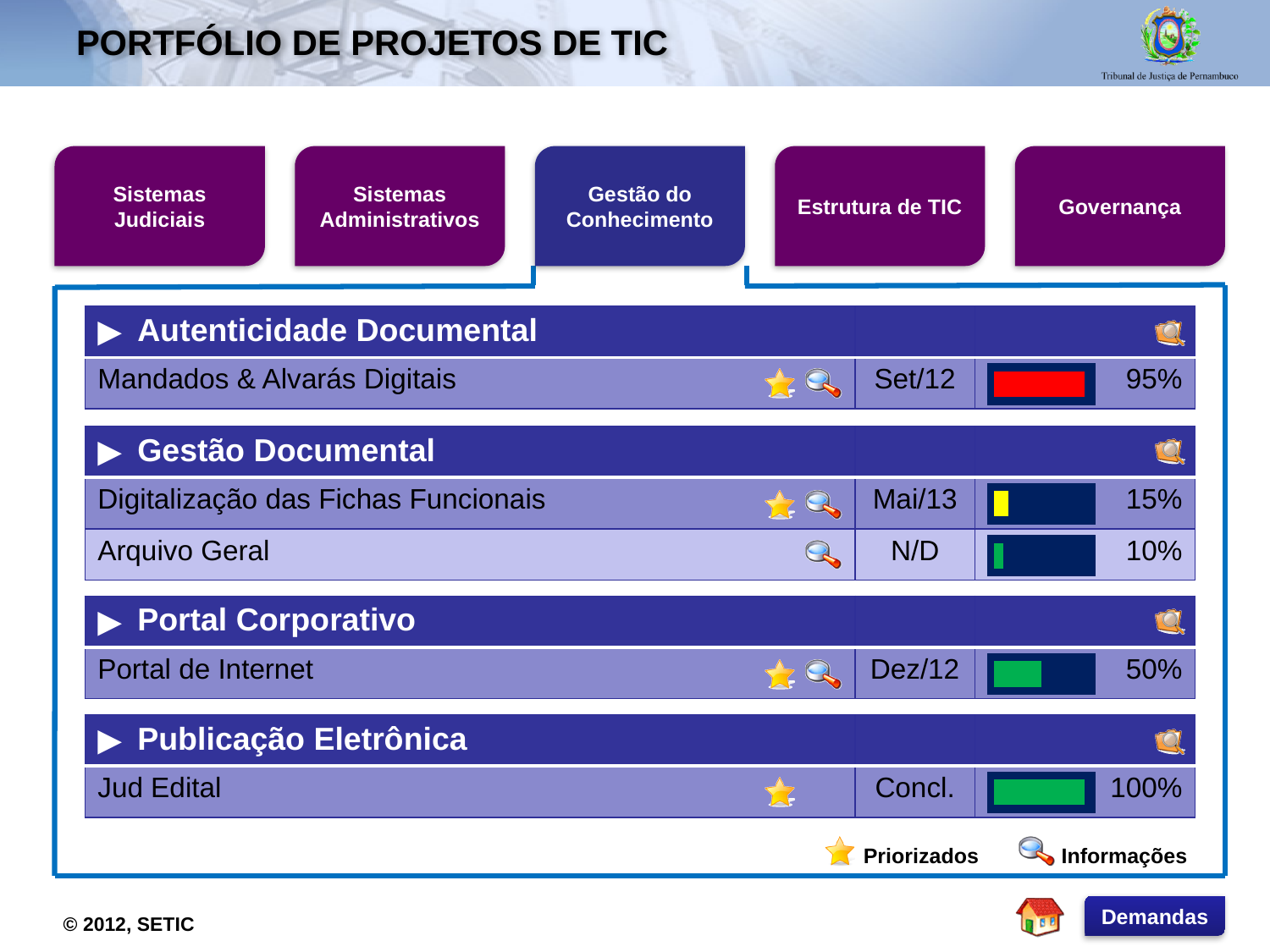
What completion percentage is shown for Jud Edital? 100% What completion percentage is shown for Arquivo Geral? 10% What is the difference in completion percentage between Mandados & Alvarás Digitais and Portal de Internet? 45% Which project has the lowest completion percentage? Arquivo Geral Which has a higher completion percentage, Digitalização das Fichas Funcionais or Portal de Internet? Portal de Internet Which project has the highest completion percentage? Jud Edital What colour is the progress bar for Mandados & Alvarás Digitais? Red What completion percentage is shown for Portal de Internet? 50% What date is shown next to Portal de Internet? Dez/12 What completion percentage is shown for Mandados & Alvarás Digitais? 95% What completion percentage is shown for Digitalização das Fichas Funcionais? 15% How many projects have a progress bar shown on the slide? 5